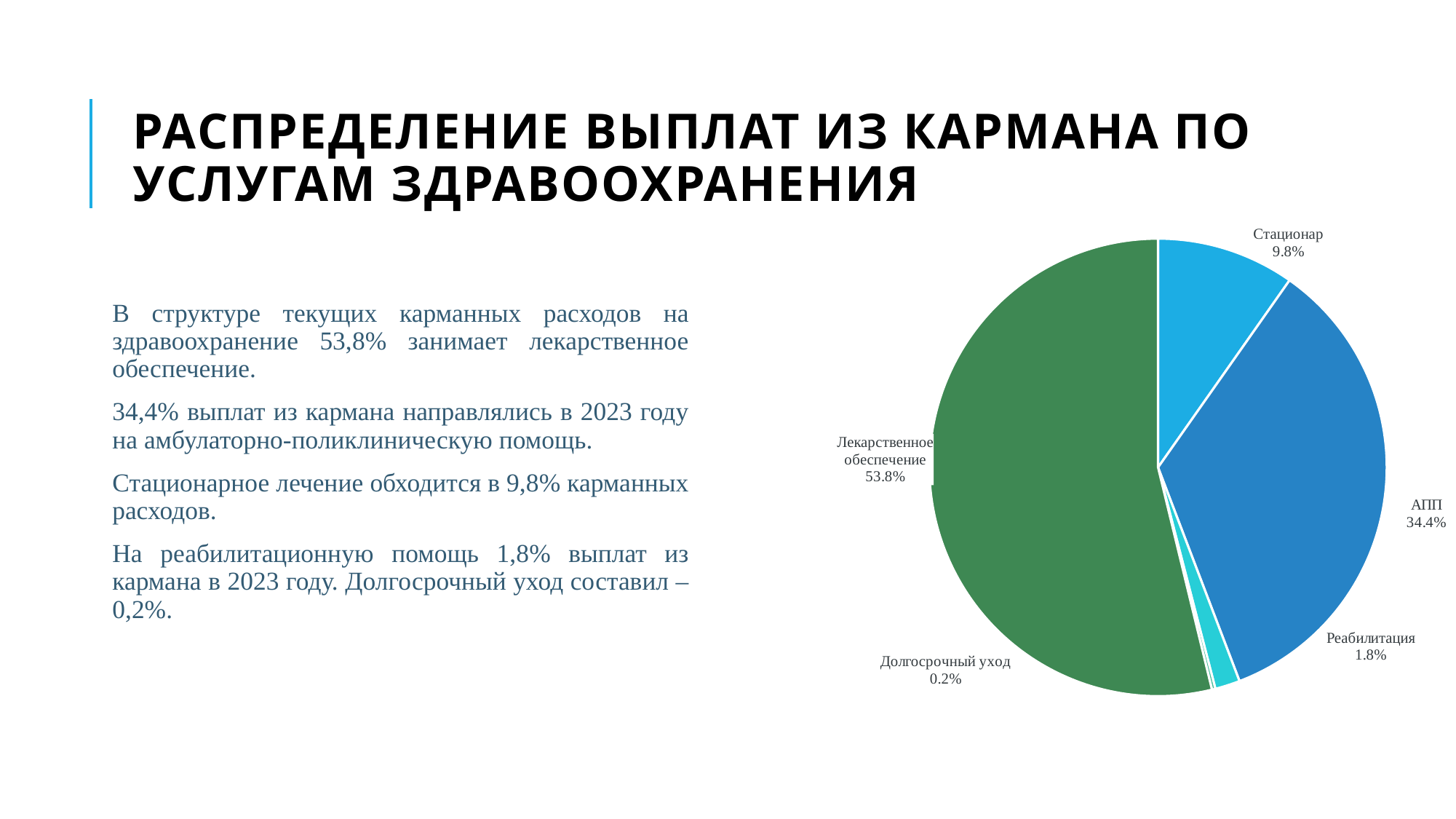
What kind of chart is shown on the slide? pie chart What is the value shown for Долгосрочный уход? 0.2% Which is larger, the share for Стационар or the share for Реабилитация? Стационар What is the value shown for Стационар? 9.8% What is the value shown for АПП? 34.4% What is the difference between the shares of Стационар and Реабилитация? 8.0% Which category has the smallest slice of the pie? Долгосрочный уход What share of the pie does Лекарственное обеспечение have? 53.8% Which category has the largest slice of the pie? Лекарственное обеспечение What is the value shown for Реабилитация? 1.8% How many categories are shown in the pie chart? 5 What is the difference between the shares of Лекарственное обеспечение and АПП? 19.4%